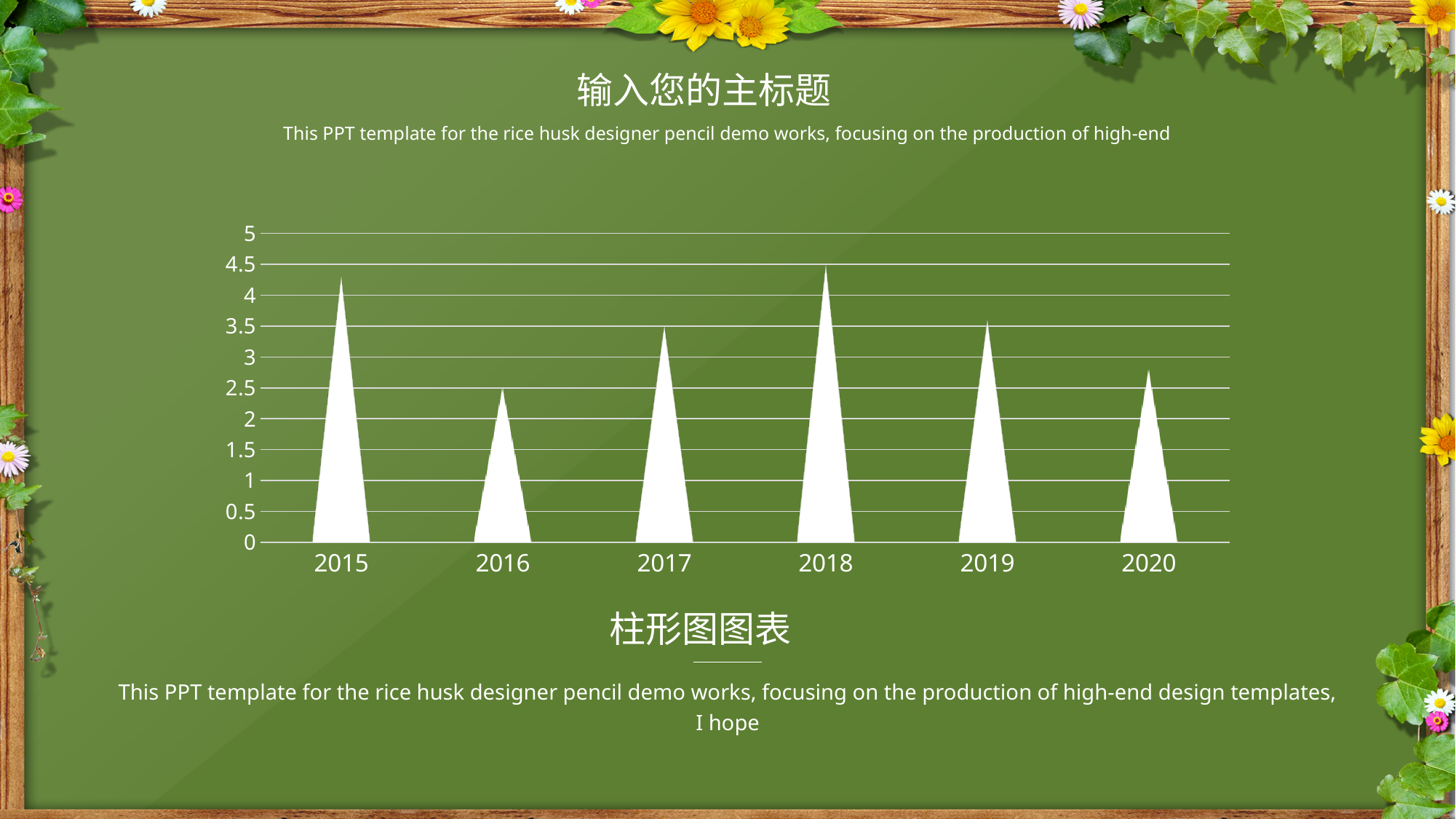
Is the value for 2020 greater or less than 3? less Which has the larger value, 2018 or 2020? 2018 What kind of chart is shown on the slide? bar chart Is the value for 2017 greater or less than 3? greater Is the value for 2018 greater or less than 4? greater Which has the larger value, 2016 or 2017? 2017 What is the highest value shown on the chart's vertical axis? 5 Which has the larger value, 2015 or 2016? 2015 What is the caption text shown directly below the chart? 柱形图图表 How many years are shown on the x axis of the chart? 6